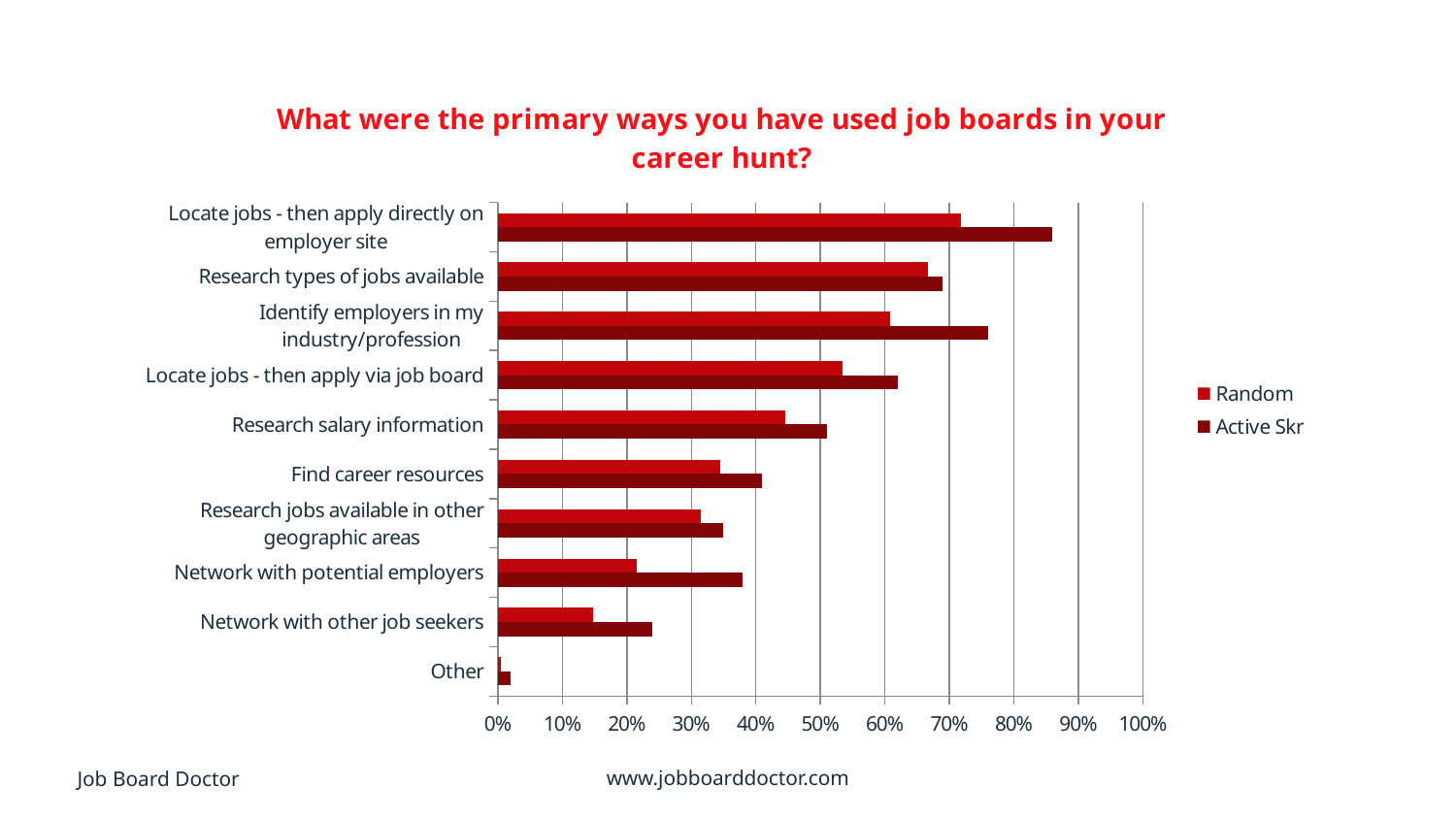
What is the title of the chart? What were the primary ways you have used job boards in your career hunt? What kind of chart is shown on the slide? bar chart What are the two series named in the legend? Random and Active Skr Is the Active Skr value for 'Locate jobs - then apply directly on employer site' greater or less than 80%? greater Which category has the lowest value for the Random series? Other For 'Network with potential employers', which series has the larger value, Random or Active Skr? Active Skr Which category has the highest value for the Active Skr series? Locate jobs - then apply directly on employer site Is the Active Skr value for 'Identify employers in my industry/profession' greater or less than 70%? greater Is the Random value for 'Research salary information' greater or less than 50%? less How many categories are plotted on the chart? 10 How many series does the legend list? 2